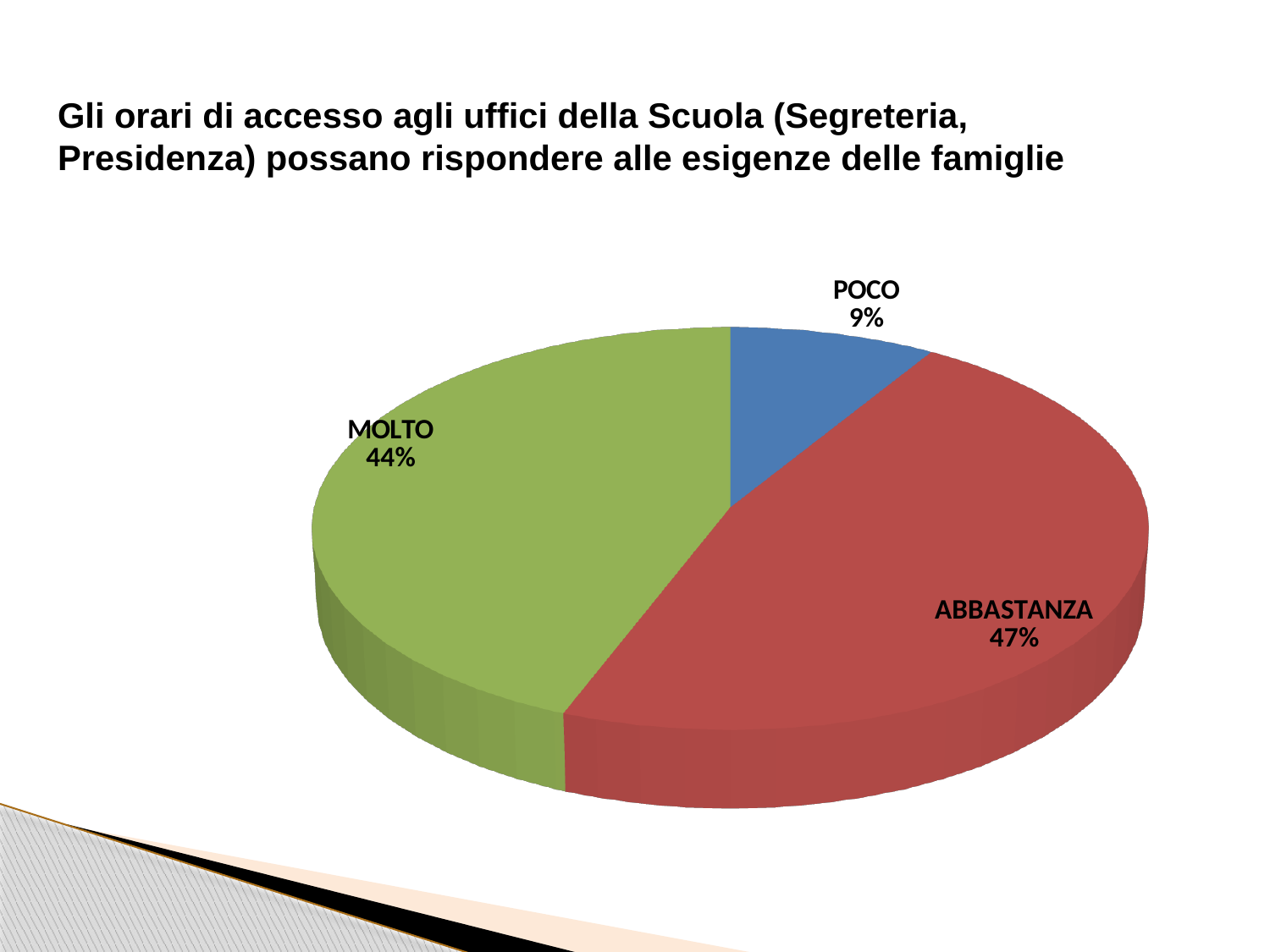
What percentage of the pie is labelled MOLTO? 44% Which category has the smallest share of the pie? POCO What is the difference in percentage points between MOLTO and POCO? 35 What kind of chart is shown on the slide? Pie chart Which category has the largest share of the pie? ABBASTANZA What colour is the slice labelled MOLTO? Green What colour is the slice labelled POCO? Blue What is the difference in percentage points between ABBASTANZA and MOLTO? 3 How many categories are shown in the pie chart? 3 What percentage of the pie is labelled POCO? 9% What percentage of the pie is labelled ABBASTANZA? 47% Which is larger, the share for MOLTO or the share for POCO? MOLTO